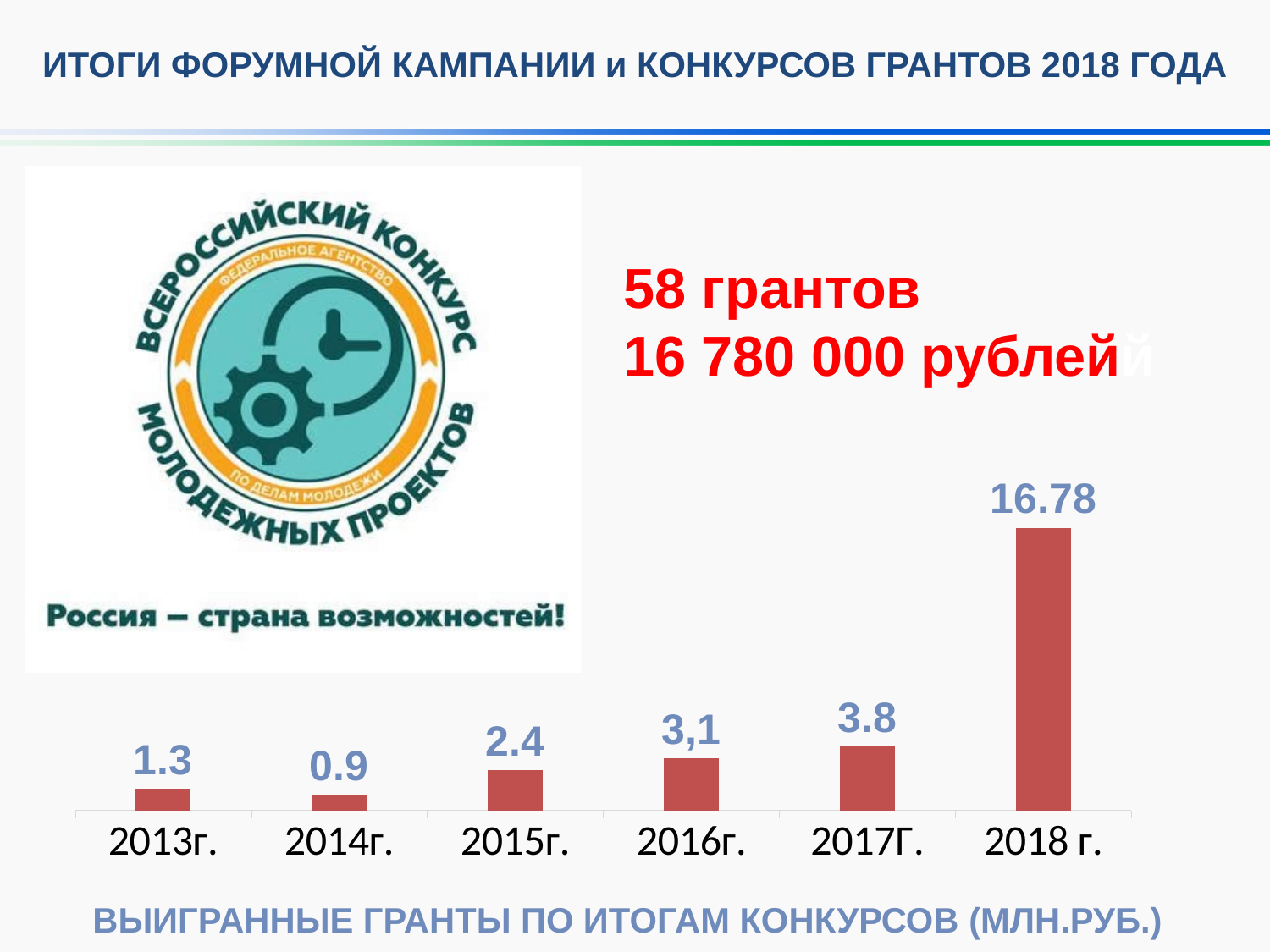
What is the difference between the values for 2015г. and 2014г.? 1.5 What is the difference between the values for 2018 г. and 2017Г.? 12.98 Which year has the lowest value in the chart? 2014г. Do the values rise or fall from 2015г. to 2018 г.? rise What is the value for 2013г. in the chart? 1.3 Which is larger, the value for 2015г. or the value for 2013г.? 2015г. What is the value for 2018 г. in the chart? 16.78 How many years are shown in the chart? 6 What is the value for 2016г. in the chart? 3,1 What kind of chart is shown on the slide? bar chart What is the value for 2014г. in the chart? 0.9 Which year has the highest value in the chart? 2018 г.